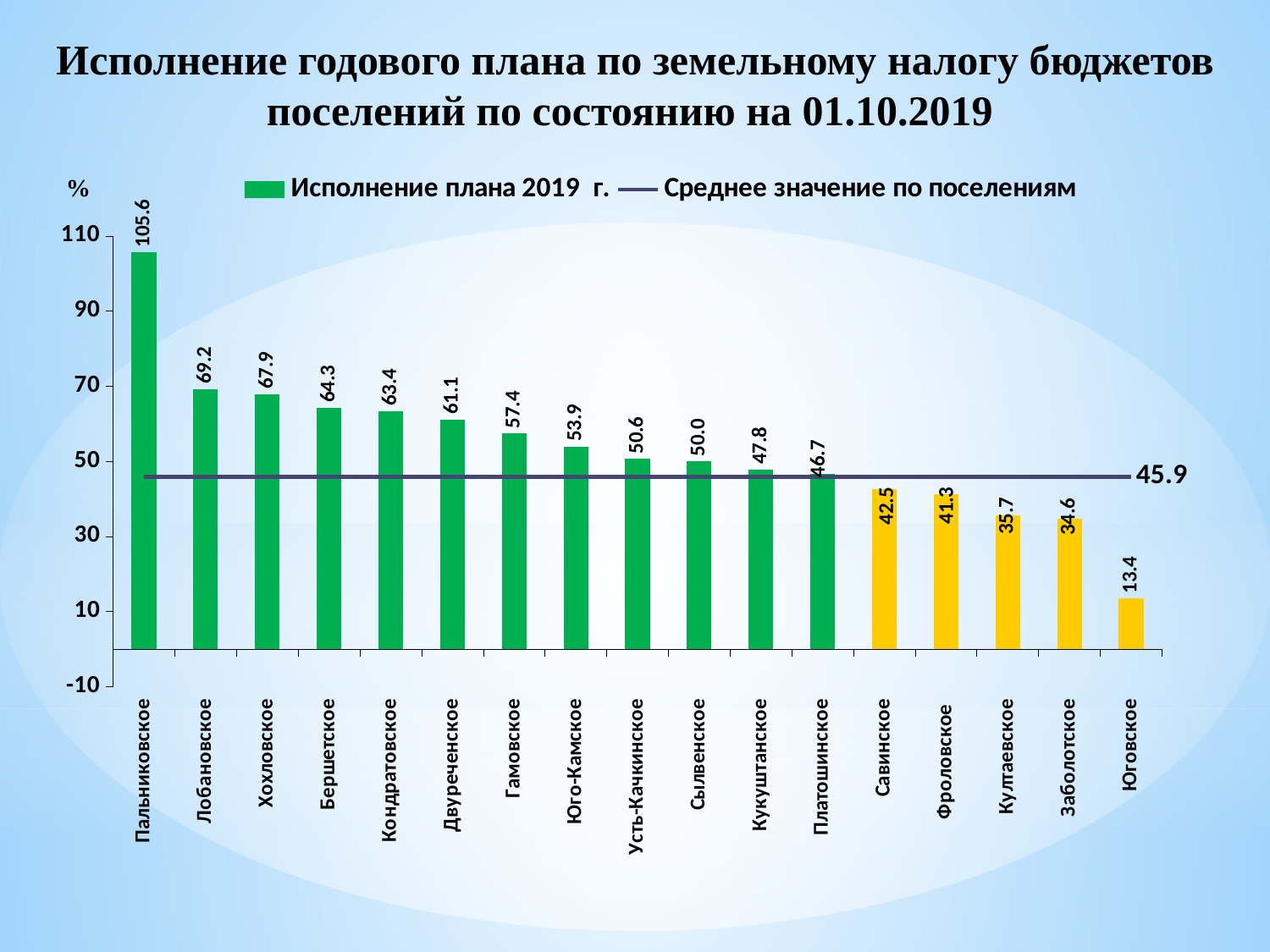
What is the value for Кондратовское? 63.4 What is the value for Пальниковское? 105.6 How many settlements are shown on the x axis? 17 Which is larger, the value for Савинское or the value for Фроловское? Савинское Which settlement has the highest value? Пальниковское How many series does the legend list? 2 Is the value for Гамовское greater or less than 50? greater What kind of chart is this? bar chart What is the value of the average line (Среднее значение по поселениям)? 45.9 What is the difference between the values for Лобановское and Хохловское? 1.3 Which settlement has the lowest value? Юговское What is the value for Юговское? 13.4